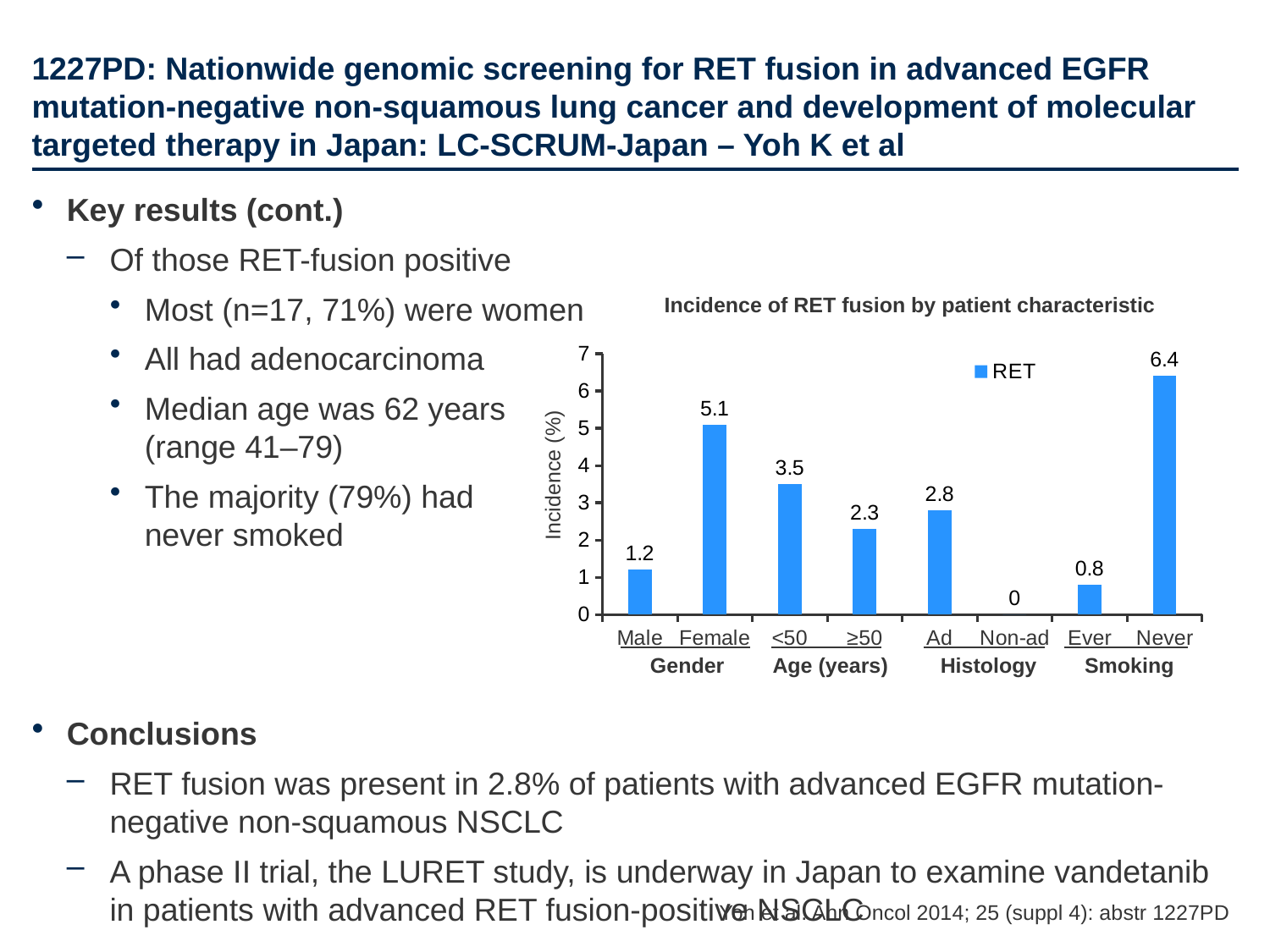
Which category has the lowest incidence of RET fusion? Non-ad What is the incidence of RET fusion for Non-ad histology? 0 What is the incidence of RET fusion for Never smokers? 6.4 What is the incidence of RET fusion for Female patients? 5.1 What is the difference in incidence between Never and Ever smokers? 5.6 What is the difference in incidence between Female and Male patients? 3.9 What type of chart is shown? Bar chart What is the title of the chart? Incidence of RET fusion by patient characteristic Which has a higher incidence of RET fusion, patients aged <50 or ≥50? <50 Which category has the highest incidence of RET fusion? Never How many categories are plotted in the chart? 8 What is the incidence of RET fusion for patients aged <50? 3.5